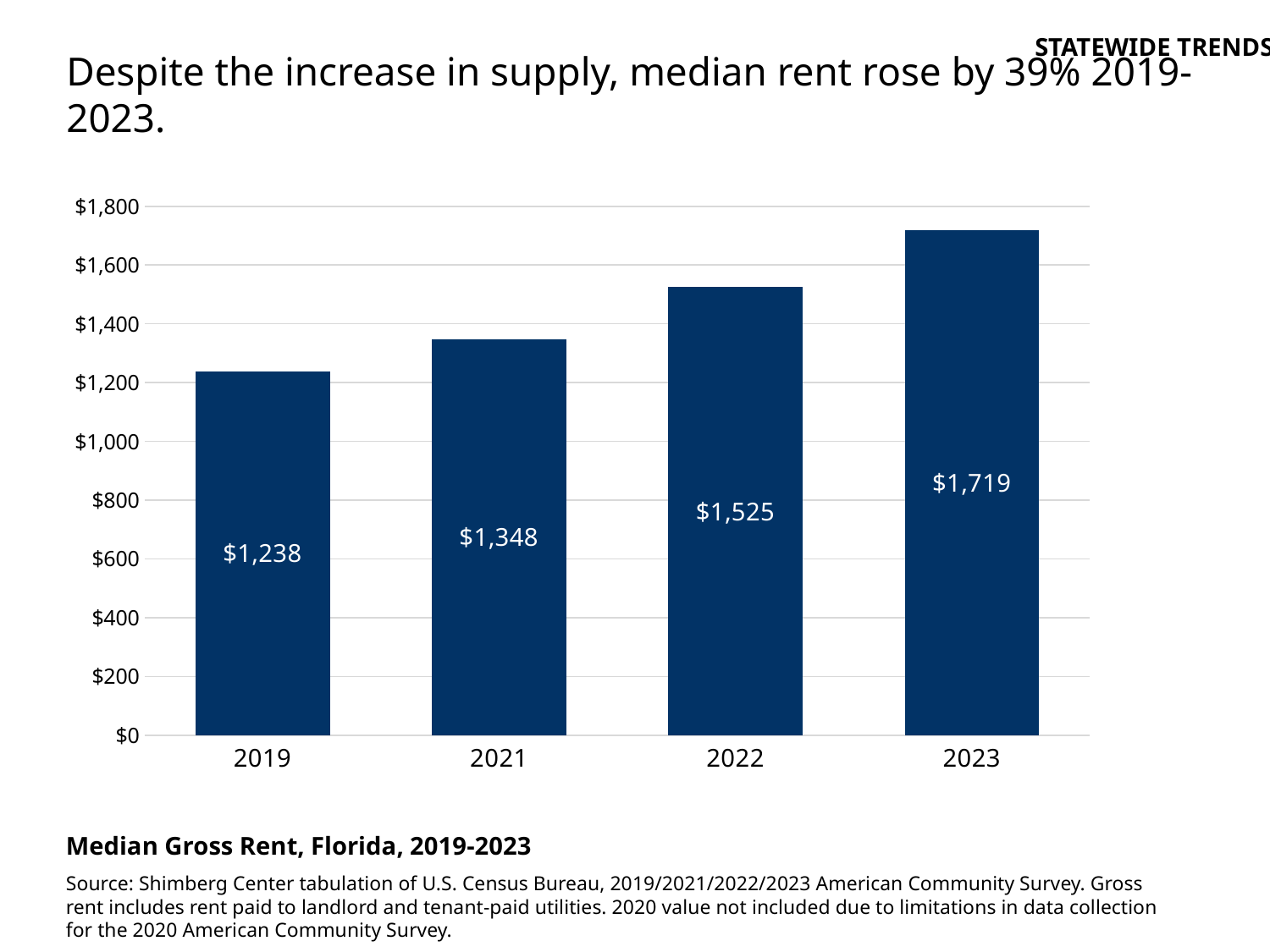
What is the difference in median gross rent between 2023 and 2019? $481 Does the median gross rent rise or fall from 2019 to 2023? rise What was the median gross rent in Florida in 2019? $1,238 Which year has the highest median gross rent? 2023 Is the median gross rent for 2021 greater or less than $1,400? less What kind of chart is shown on the slide? bar chart Which year had a higher median gross rent, 2021 or 2022? 2022 What was the median gross rent in Florida in 2023? $1,719 How many years are shown on the chart? 4 Which year has the lowest median gross rent? 2019 What is the difference in median gross rent between 2022 and 2021? $177 What was the median gross rent in Florida in 2022? $1,525